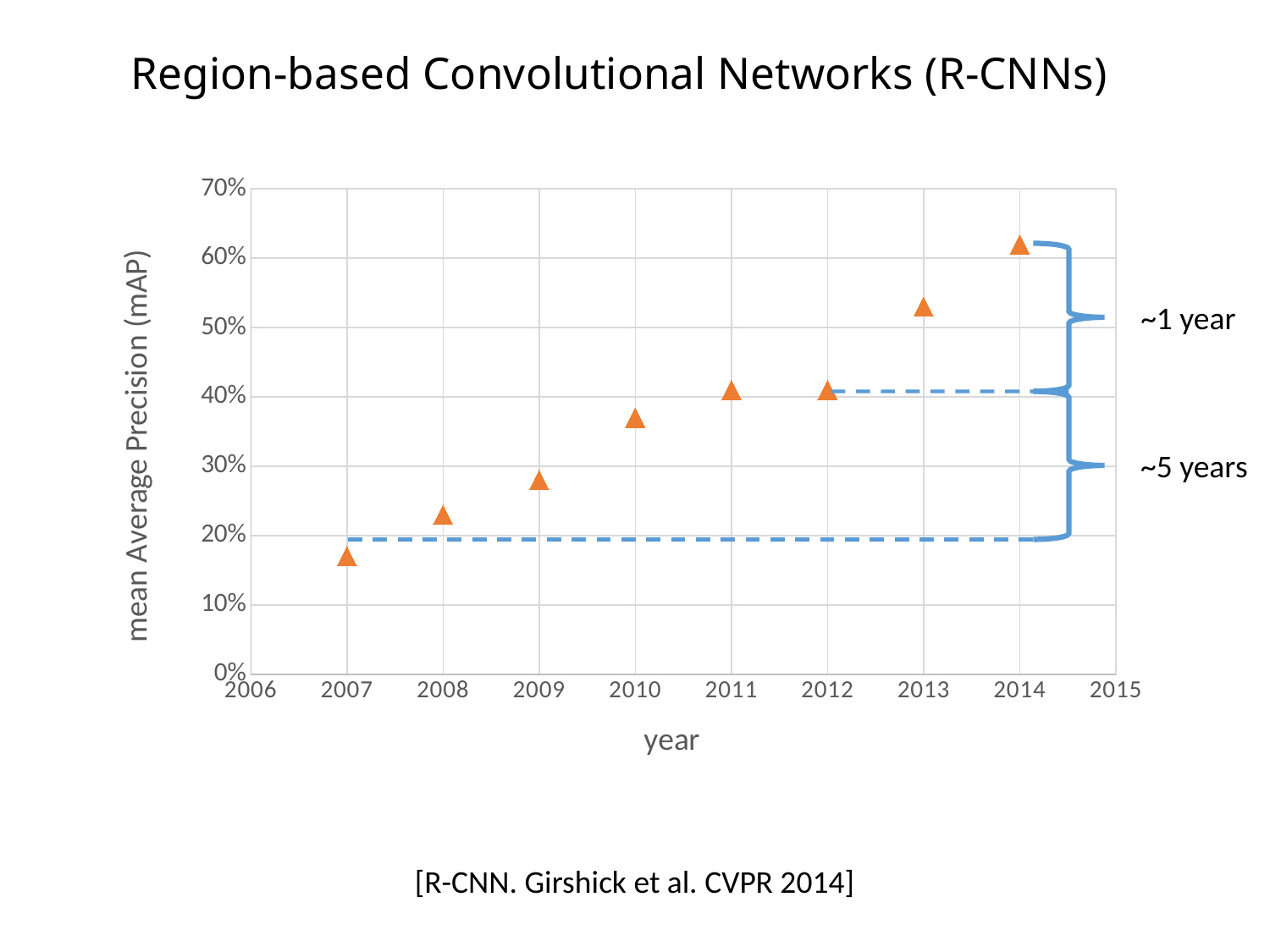
Is the value for 2009 greater or less than 30%? less Do the mAP values generally rise or fall from 2007 to 2014? rise Which year has a higher mAP, 2010 or 2013? 2013 Which year has the highest mean Average Precision? 2014 Is the value for 2013 greater or less than 50%? greater What kind of chart is shown on the slide? scatter chart Is the value for 2014 greater or less than 60%? greater How many data points are plotted on the chart? 8 Which year has the lowest mean Average Precision? 2007 What is the label of the vertical axis? mean Average Precision (mAP)